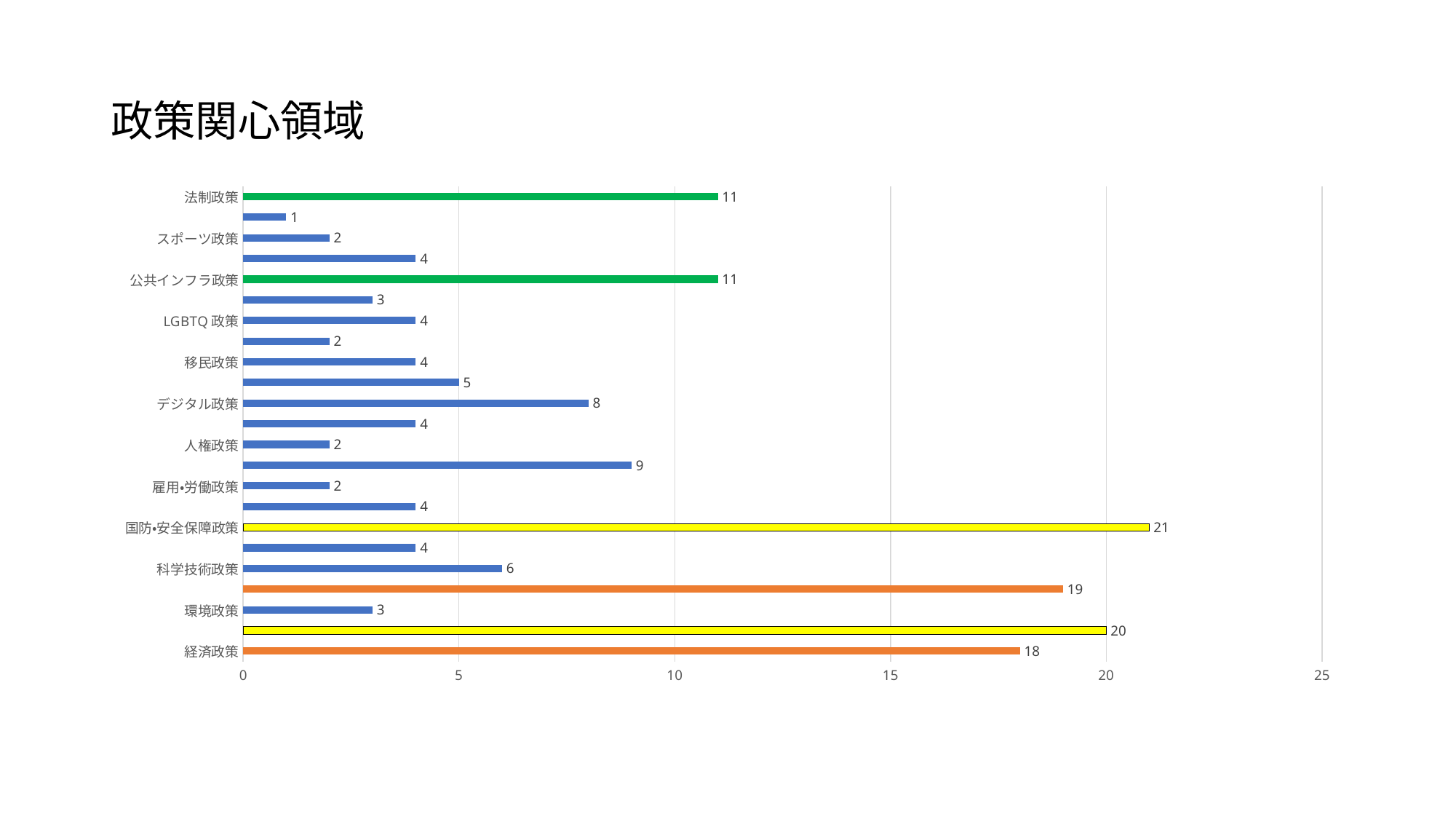
What is the value for 公共インフラ政策? 11 What is the value for デジタル政策? 8 Which is larger, the value for 科学技術政策 or the value for 環境政策? 科学技術政策 Which labeled category has the highest value? 国防•安全保障政策 What is the value for 国防•安全保障政策? 21 What is the value for 法制政策? 11 What is the title of the slide? 政策関心領域 What is the difference between the values for デジタル政策 and 人権政策? 6 Is the value for 経済政策 greater or less than 15? greater What is the value for 経済政策? 18 What kind of chart is shown on the slide? bar chart What is the difference between the values for 国防•安全保障政策 and 経済政策? 3